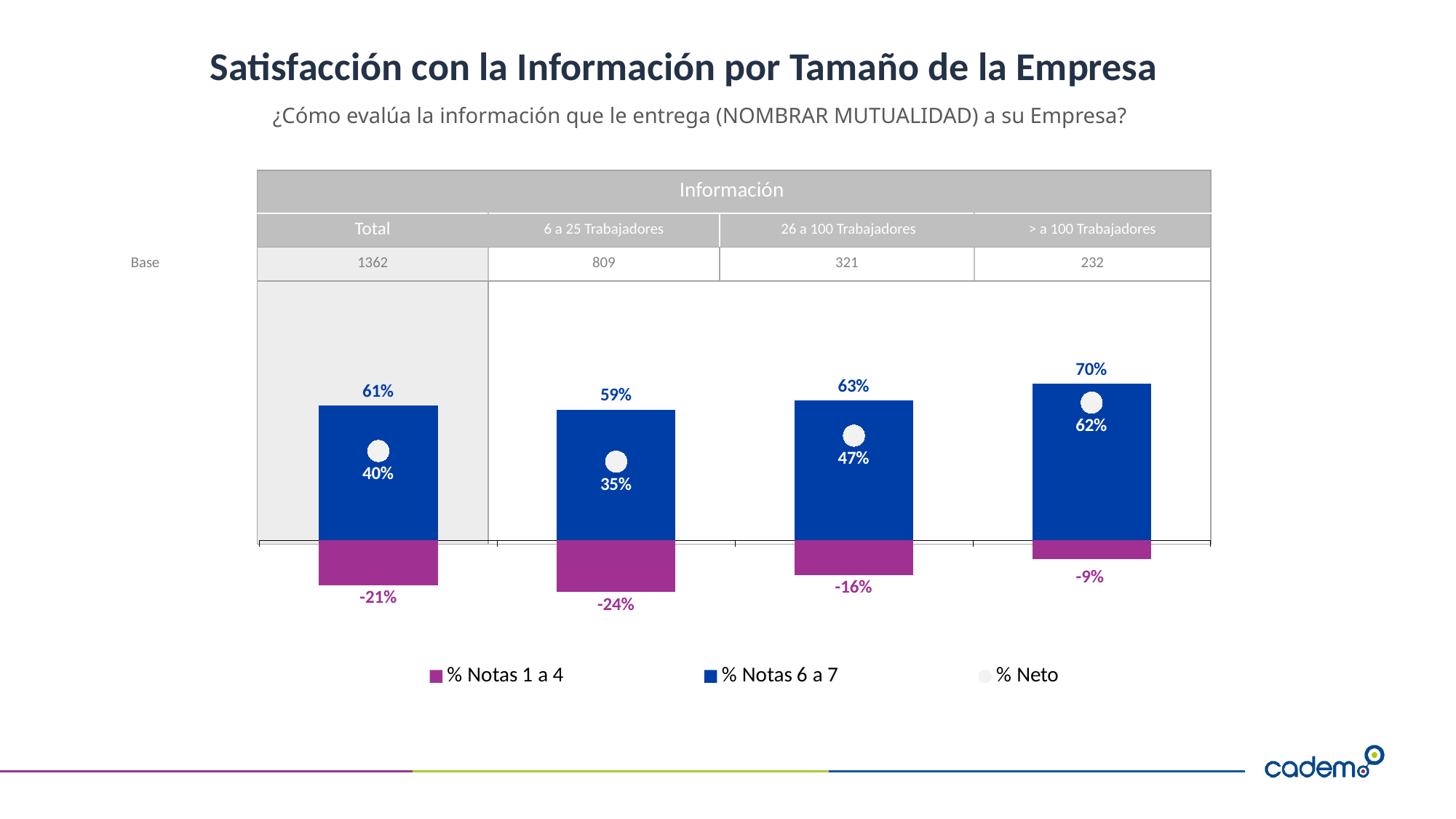
How many categories are shown on the x axis? 4 Which category has the lowest % Neto value? 6 a 25 Trabajadores What kind of chart is shown on the slide? Combination bar and line chart (bars with dot markers for % Neto) Which category has the highest % Notas 6 a 7 value? > a 100 Trabajadores What is the difference between the % Notas 6 a 7 values for > a 100 Trabajadores and 6 a 25 Trabajadores? 11 percentage points What is the % Notas 6 a 7 value for Total? 61% How many series does the legend list? 3 Which is larger, the % Neto for Total or the % Neto for 26 a 100 Trabajadores? 26 a 100 Trabajadores What is the % Notas 6 a 7 value for > a 100 Trabajadores? 70% What is the Base value shown for 26 a 100 Trabajadores? 321 What is the % Notas 1 a 4 value for 6 a 25 Trabajadores? -24% What is the % Neto value for 26 a 100 Trabajadores? 47%